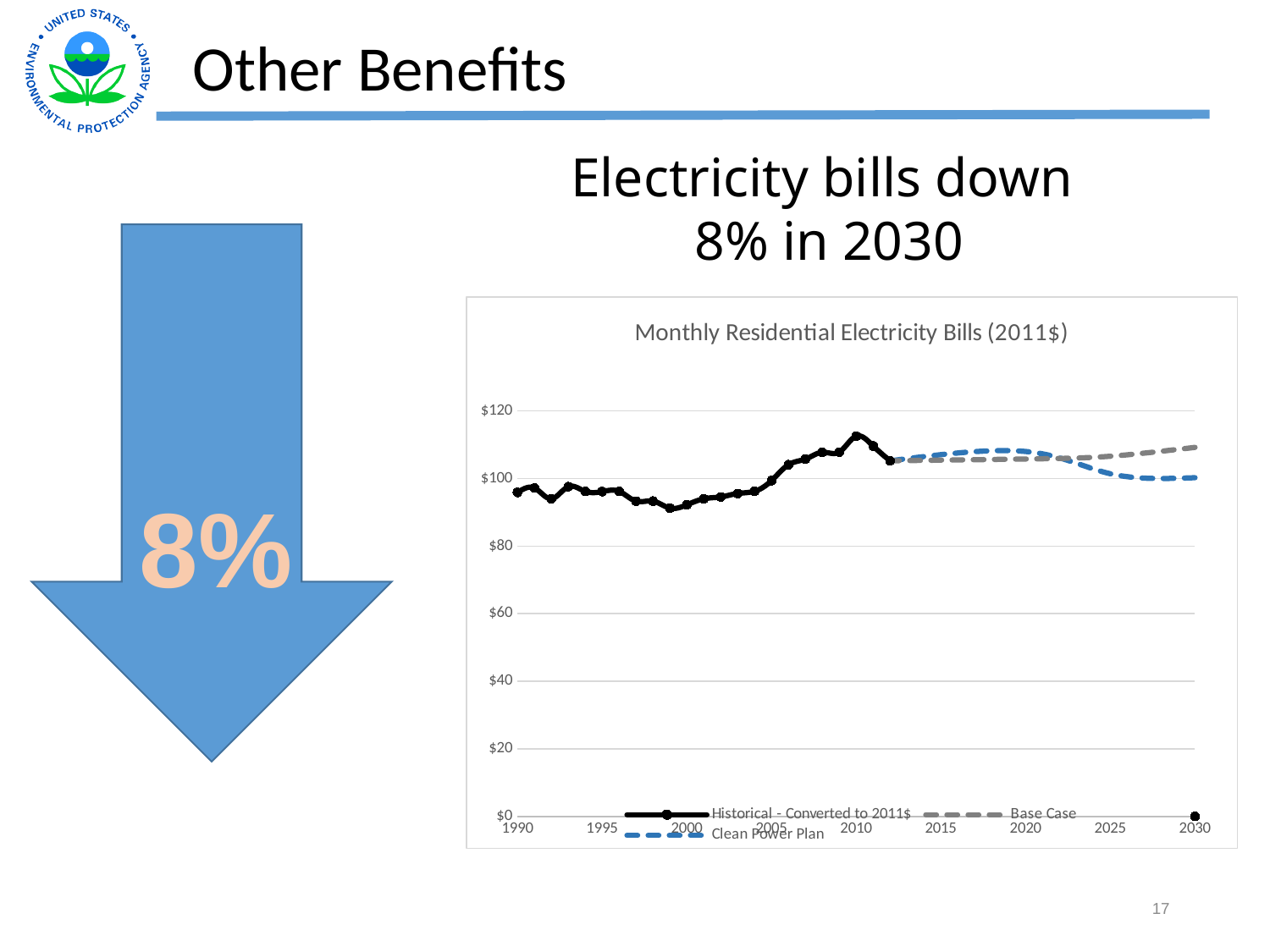
How many series does the chart's legend list? 3 Is the Base Case value in 2030 greater or less than $100? greater Which series is drawn as a blue dashed line? Clean Power Plan Around which year does the Historical - Converted to 2011$ series reach its highest value? 2010 Does the Clean Power Plan line rise or fall between 2020 and 2030? fall What is the title of the chart? Monthly Residential Electricity Bills (2011$) Is the Historical - Converted to 2011$ value in 2010 greater or less than $100? greater Is the Historical - Converted to 2011$ value in 2000 greater or less than $100? less In 2030, which series is higher: Base Case or Clean Power Plan? Base Case What kind of chart is shown on the slide? line chart Does the Base Case line rise or fall between 2020 and 2030? rise